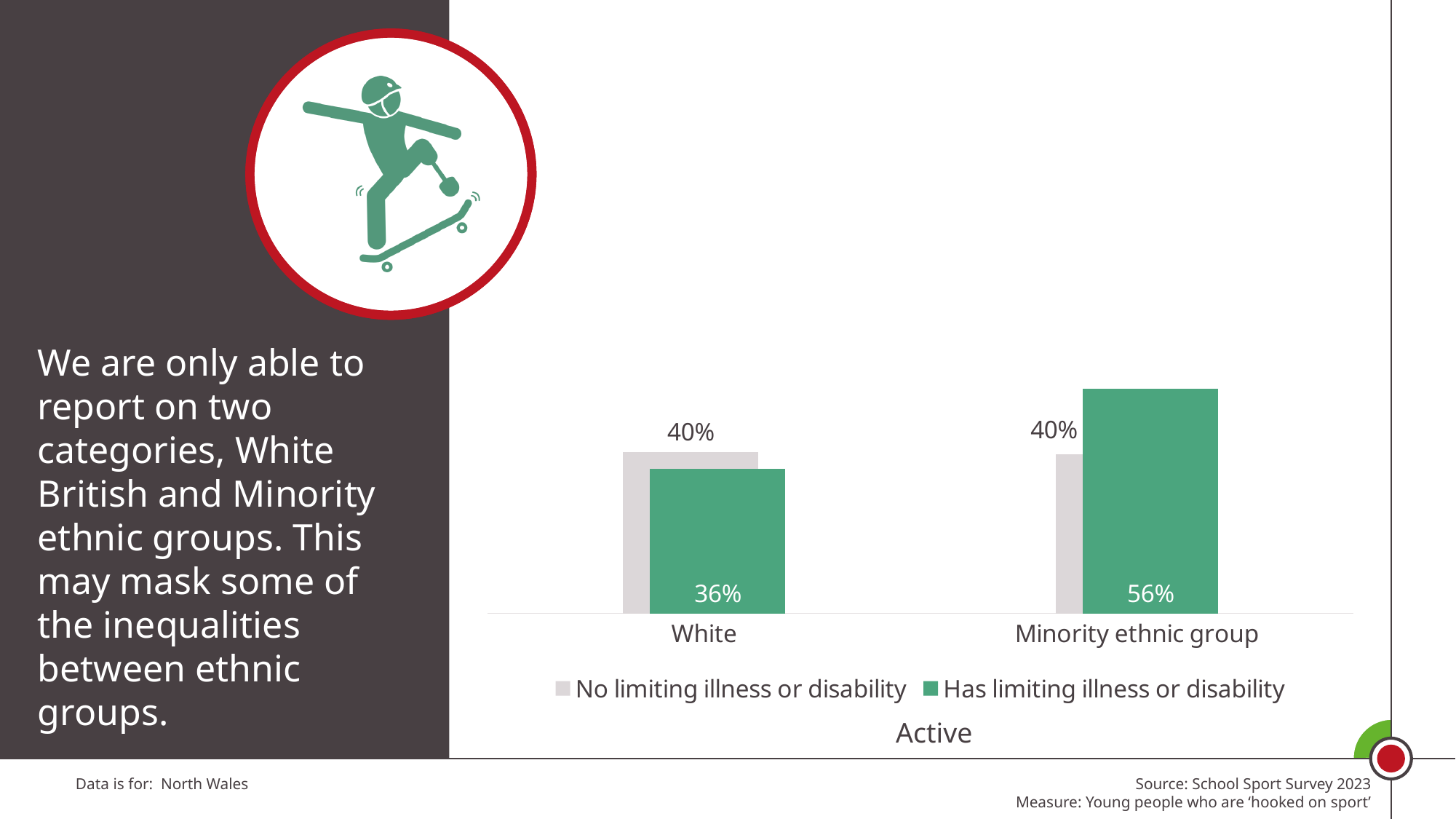
What is the value for 'Has limiting illness or disability' in the White category? 36% What is the difference between the 'Has limiting illness or disability' values for Minority ethnic group and White? 20% What kind of chart is shown on the slide? Bar chart What is the value for 'No limiting illness or disability' in the Minority ethnic group category? 40% How many categories are shown on the x axis? 2 In the White category, which is larger: 'No limiting illness or disability' or 'Has limiting illness or disability'? No limiting illness or disability In the Minority ethnic group category, which is larger: 'No limiting illness or disability' or 'Has limiting illness or disability'? Has limiting illness or disability What is the value for 'No limiting illness or disability' in the White category? 40% Which category has the highest value for 'Has limiting illness or disability'? Minority ethnic group How many series does the legend list? 2 What is the value for 'Has limiting illness or disability' in the Minority ethnic group category? 56% In the White category, what is the difference between 'No limiting illness or disability' and 'Has limiting illness or disability'? 4%